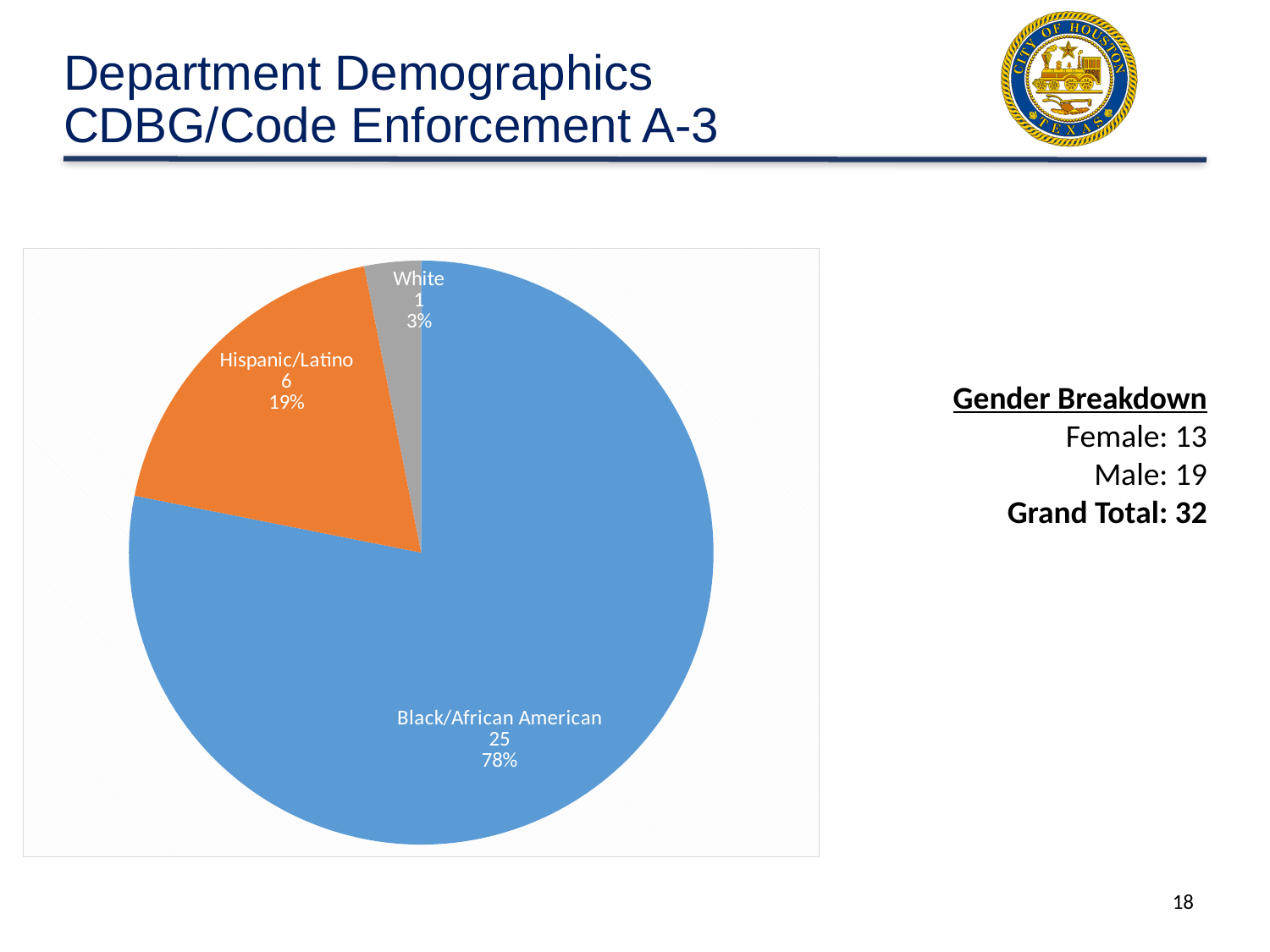
How many slices does the pie chart have? 3 What is the value for Hispanic/Latino in the pie chart? 6 What kind of chart is shown on the slide? pie chart What is the value for Black/African American in the pie chart? 25 Which category has the smallest slice in the pie chart? White What is the value for White in the pie chart? 1 What share of the pie does Black/African American represent? 78% What share of the pie does Hispanic/Latino represent? 19% Which category has the largest slice in the pie chart? Black/African American What share of the pie does White represent? 3% What is the difference between the values for Black/African American and Hispanic/Latino? 19 Which is larger, the value for Hispanic/Latino or the value for White? Hispanic/Latino